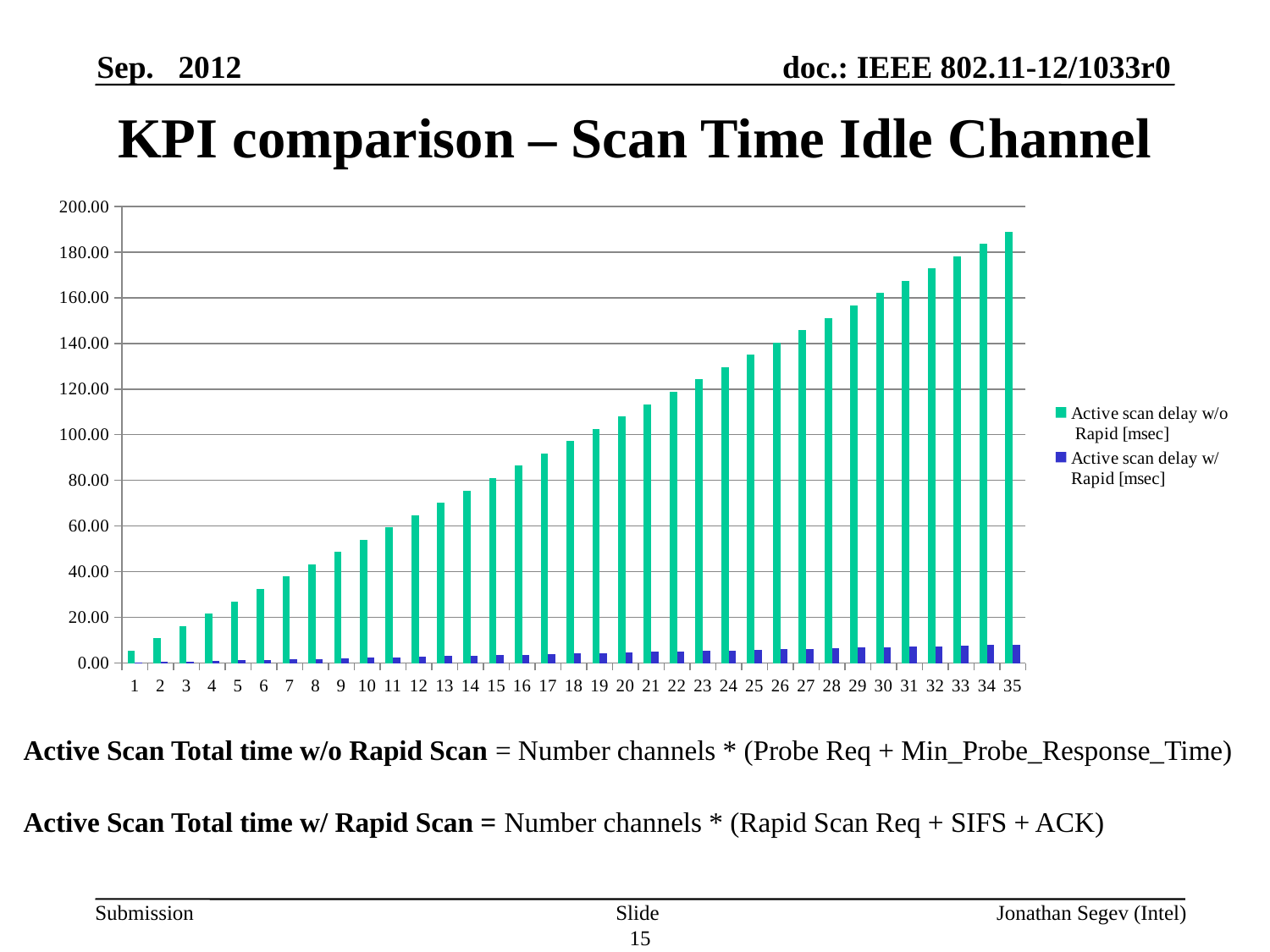
For category 35, which series has the larger value: 'Active scan delay w/o Rapid [msec]' or 'Active scan delay w/ Rapid [msec]'? Active scan delay w/o Rapid [msec] What kind of chart is shown on the slide? bar chart Is the value for category 35 in the 'Active scan delay w/ Rapid [msec]' series greater or less than 20? less Which category has the lowest value for the 'Active scan delay w/o Rapid [msec]' series? 1 Which category has the highest value for the 'Active scan delay w/o Rapid [msec]' series? 35 How many series does the chart's legend list? 2 Do the values of the 'Active scan delay w/o Rapid [msec]' series rise or fall as the category number increases along the x axis? rise Is the value for category 35 in the 'Active scan delay w/o Rapid [msec]' series greater or less than 180? greater Is the value for category 10 in the 'Active scan delay w/o Rapid [msec]' series greater or less than 40? greater Which series is drawn in green in the chart? Active scan delay w/o Rapid [msec] How many categories are shown along the x axis of the chart? 35